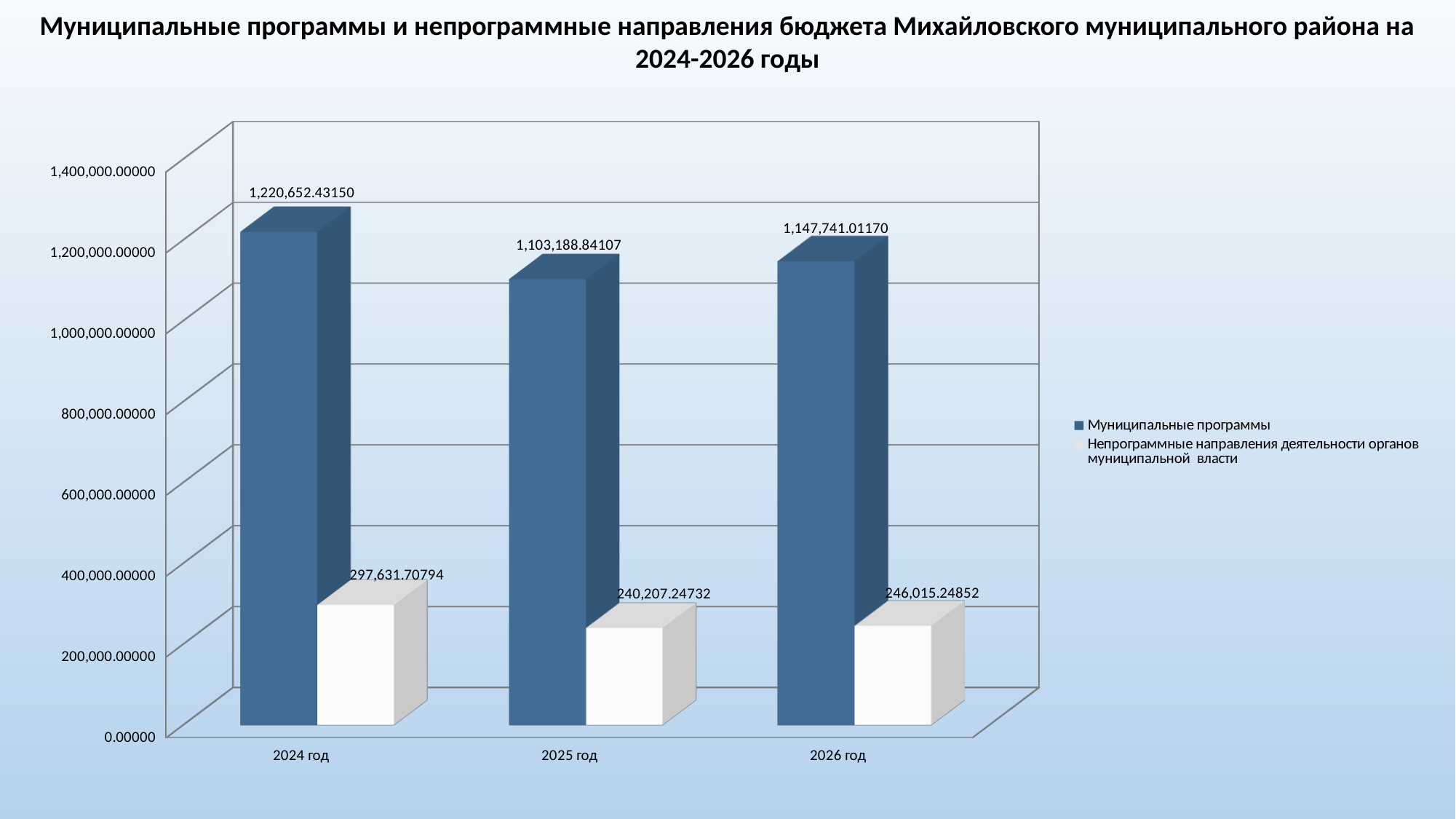
What is the value for Непрограммные направления деятельности органов муниципальной власти in 2026 год? 246,015.24852 How many years are shown on the x axis? 3 Which is larger: the Муниципальные программы value for 2025 год or for 2026 год? 2026 год How many series does the legend list? 2 What is the difference between the Непрограммные направления values for 2024 год and 2025 год? 57,424.46062 What is the value for Муниципальные программы in 2026 год? 1,147,741.01170 In which year is the value for Непрограммные направления деятельности органов муниципальной власти the lowest? 2025 год Is the value for Муниципальные программы in 2025 год greater or less than 1,200,000.00000? less What is the difference between the Муниципальные программы values for 2024 год and 2025 год? 117,463.59043 What is the value for Муниципальные программы in 2024 год? 1,220,652.43150 What is the value for Непрограммные направления деятельности органов муниципальной власти in 2025 год? 240,207.24732 In which year is the value for Муниципальные программы the highest? 2024 год